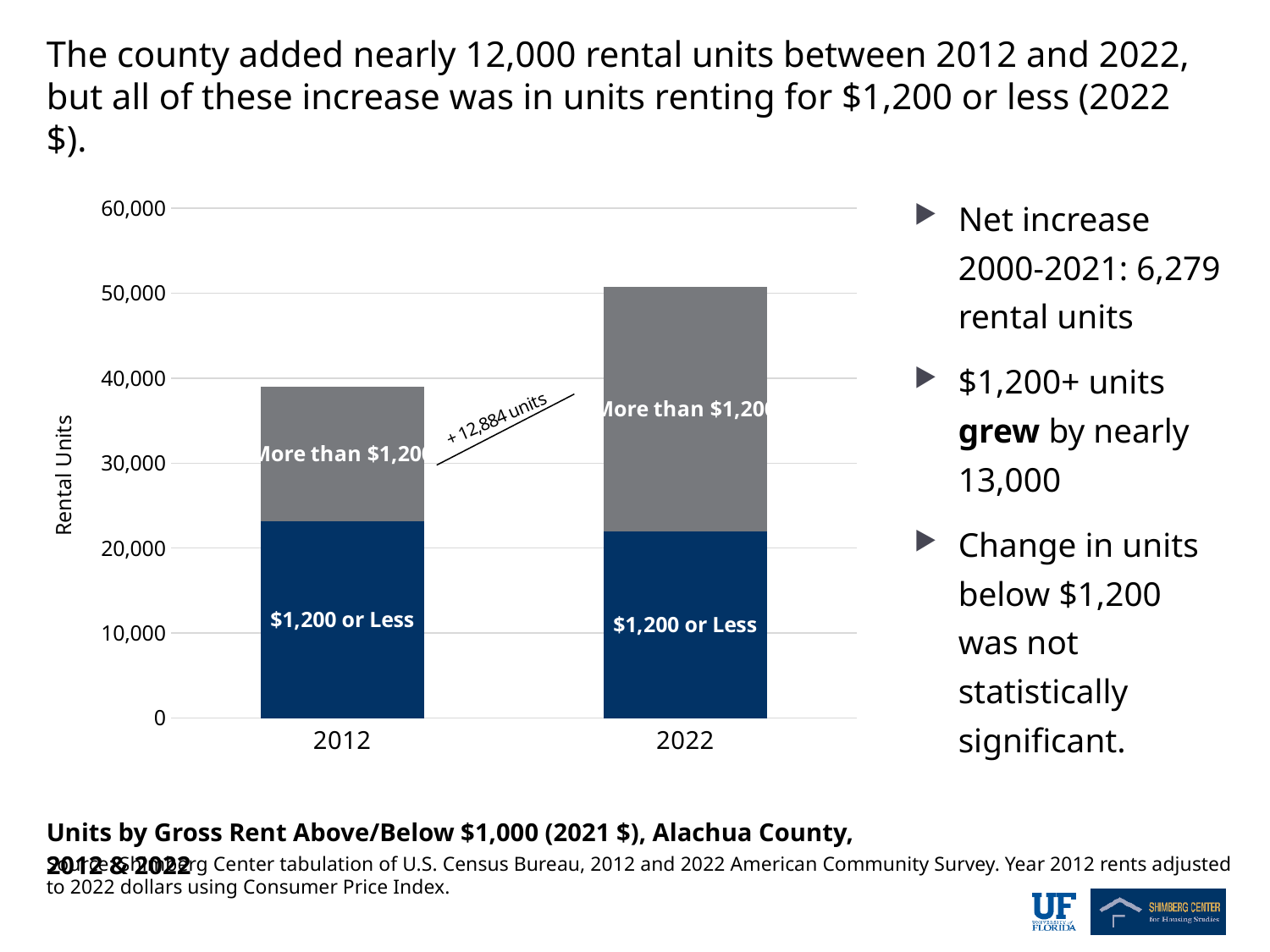
How many years are shown on the x axis of the chart? 2 Is the "$1,200 or Less" segment for 2012 greater or less than 20,000? greater Is the total number of rental units for 2012 greater or less than 30,000? greater In the 2012 bar, which segment is larger, "$1,200 or Less" or "More than $1,200"? $1,200 or Less In the 2022 bar, which segment is larger, "$1,200 or Less" or "More than $1,200"? More than $1,200 How many rent categories are stacked in each bar of the chart? 2 What kind of chart is shown on the slide? bar chart Which year has the taller total bar, 2012 or 2022? 2022 Is the total number of rental units for 2022 greater or less than 40,000? greater What does the annotation between the two bars say? + 12,884 units Does the total number of rental units rise or fall from 2012 to 2022? rise